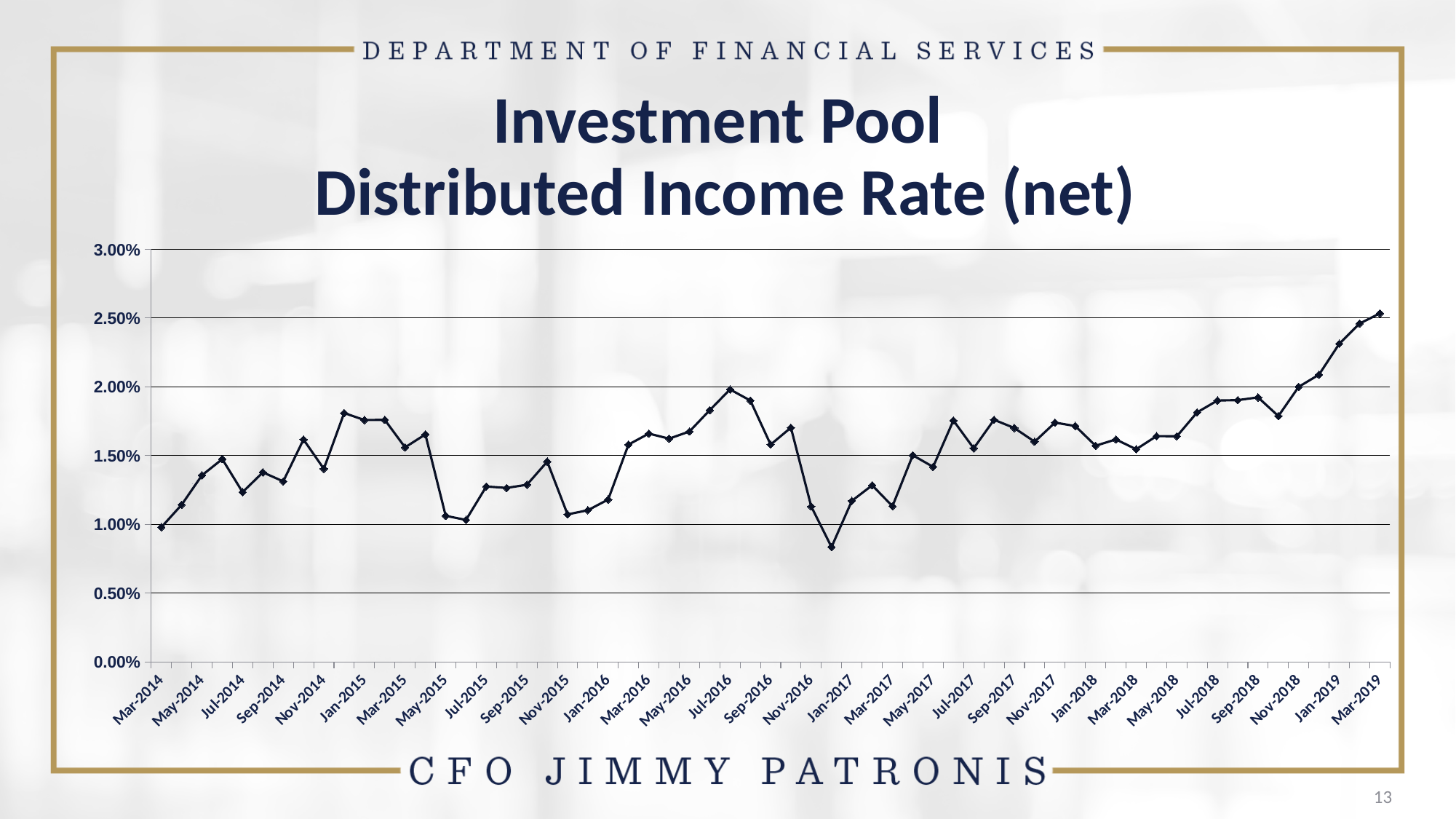
Is the value for May-2015 greater or less than 1.50%? less Is the value for Jan-2016 greater or less than 1.50%? less Which is higher, the value for Jul-2016 or the value for Jan-2017? Jul-2016 Is the value for Mar-2019 greater or less than 2.00%? greater What kind of chart is shown on the slide? line chart Which labeled month on the x axis has the highest distributed income rate? Mar-2019 Overall, does the distributed income rate rise or fall from Mar-2014 to Mar-2019? rise What is the highest value shown on the y axis? 3.00% What is the title of the chart? Investment Pool Distributed Income Rate (net)